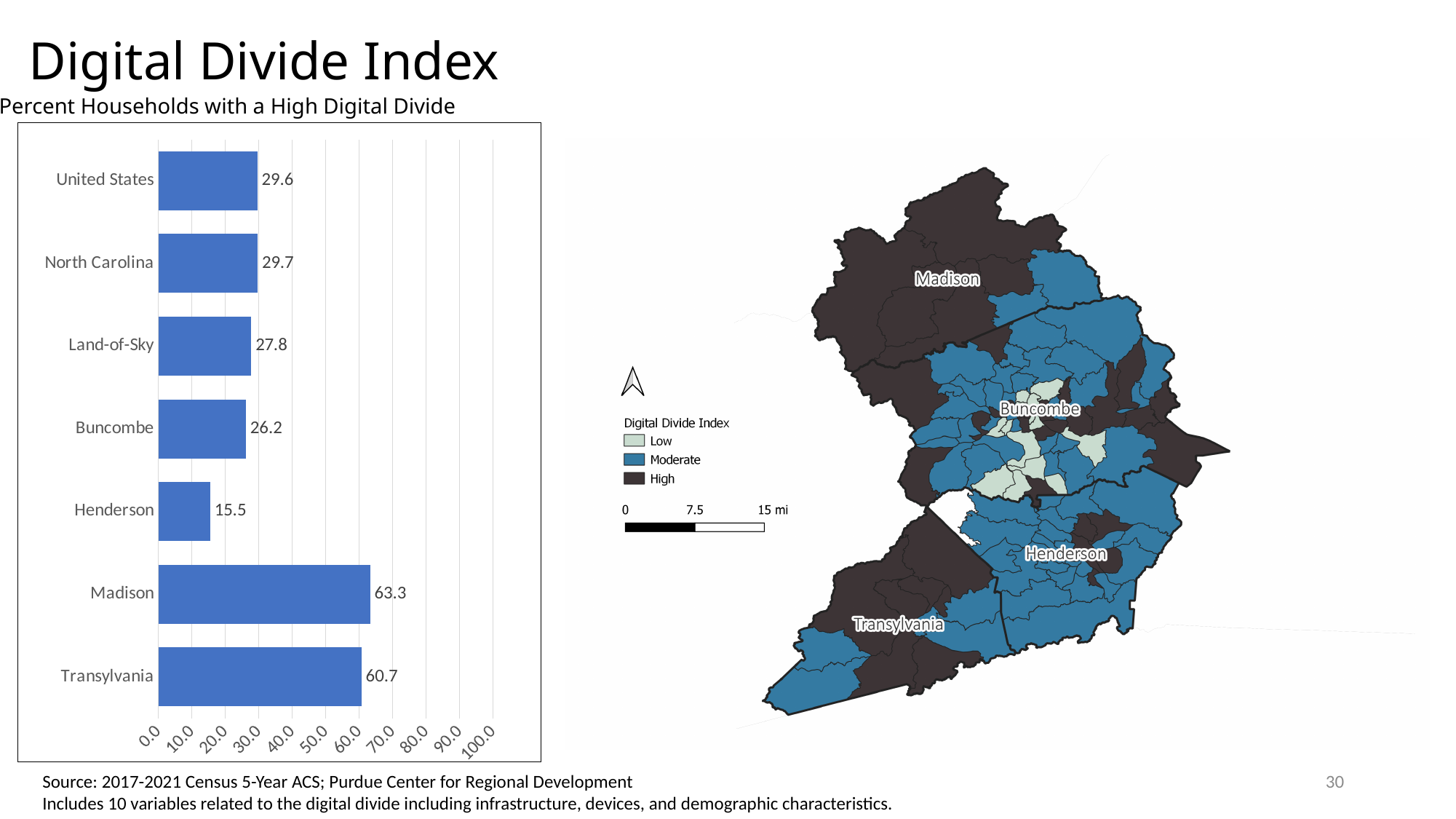
What kind of chart is shown on the left of the slide? Bar chart What is the difference between the values for North Carolina and Buncombe in the bar chart? 3.5 What is the value for the United States in the bar chart? 29.6 What is the value for Henderson in the bar chart? 15.5 What is the value for Land-of-Sky in the bar chart? 27.8 Which category has the highest value in the bar chart? Madison How many categories are shown in the bar chart? 7 Which is larger in the bar chart, the value for Buncombe or the value for Henderson? Buncombe What is the value for Madison in the bar chart? 63.3 What is the title of the bar chart? Percent Households with a High Digital Divide What is the difference between the values for Madison and Transylvania in the bar chart? 2.6 Which category has the lowest value in the bar chart? Henderson